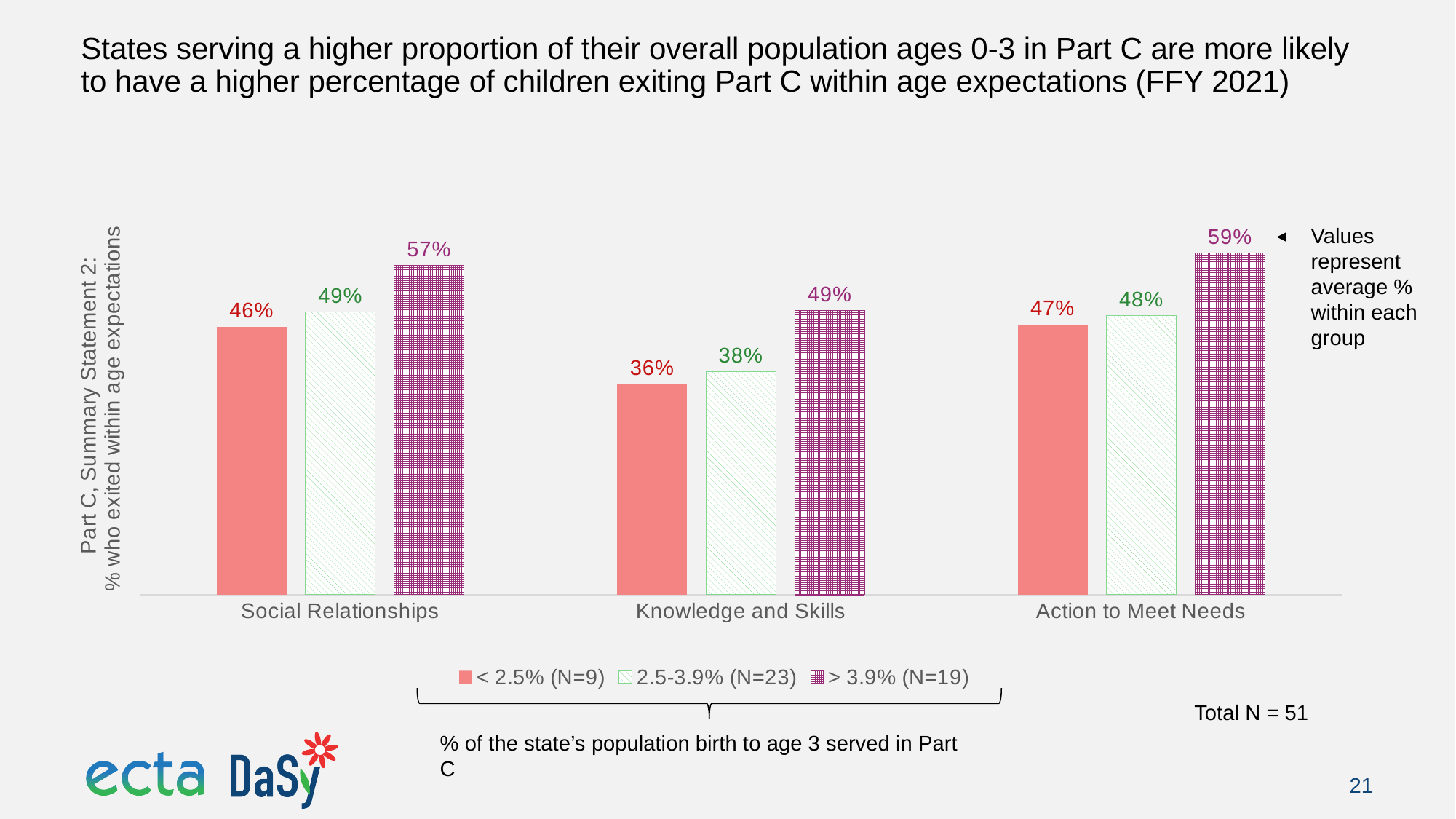
Which is larger in the Social Relationships category: the < 2.5% (N=9) group or the 2.5-3.9% (N=23) group? 2.5-3.9% (N=23) Which category has the lowest value for the < 2.5% (N=9) group? Knowledge and Skills What is the value for the > 3.9% (N=19) group in the Social Relationships category? 57% What is the value for the < 2.5% (N=9) group in the Knowledge and Skills category? 36% How many categories are shown on the x axis? 3 Which category has the highest value for the > 3.9% (N=19) group? Action to Meet Needs What is the total N stated on the slide? 51 What is the difference between the > 3.9% (N=19) group and the < 2.5% (N=9) group in the Knowledge and Skills category? 13 percentage points What kind of chart is shown on the slide? Bar chart How many series does the legend list? 3 What is the value for the 2.5-3.9% (N=23) group in the Action to Meet Needs category? 48% What is the y-axis label of the chart? Part C, Summary Statement 2: % who exited within age expectations